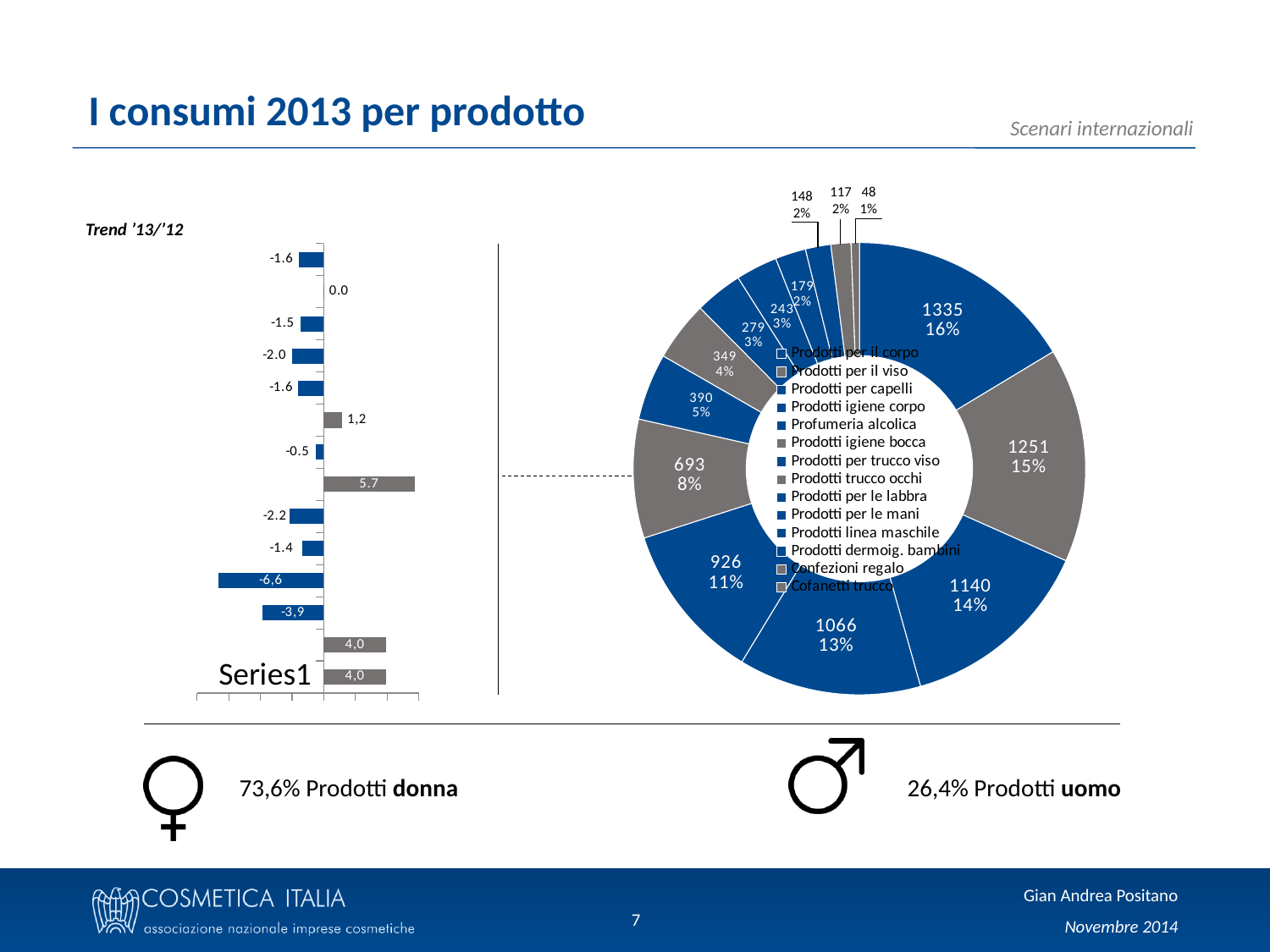
In the pie chart on the right, what value is shown for the largest slice (Prodotti per il corpo)? 1335 In the 'Trend '13/'12' bar chart on the left, what is the largest value shown on a bar? 5.7 What kind of chart is the chart on the right of the slide? pie chart (doughnut) In the pie chart on the right, which category has the largest slice? Prodotti per il corpo What kind of chart is the 'Trend '13/'12' chart on the left of the slide? bar chart In the pie chart on the right, which category has the smallest slice? Cofanetti trucco In the 'Trend '13/'12' bar chart on the left, what is the lowest value shown on a bar? -6,6 In the pie chart on the right, which is larger: the slice labelled 1140 or the slice labelled 926? 1140 In the pie chart on the right, how many entries does the legend list? 14 In the pie chart on the right, what value is shown for Prodotti per il viso? 1251 In the pie chart on the right, what is the difference between the values for Prodotti per il corpo (1335) and Prodotti per il viso (1251)? 84 In the pie chart on the right, what share of the total does Prodotti per il corpo represent? 16%